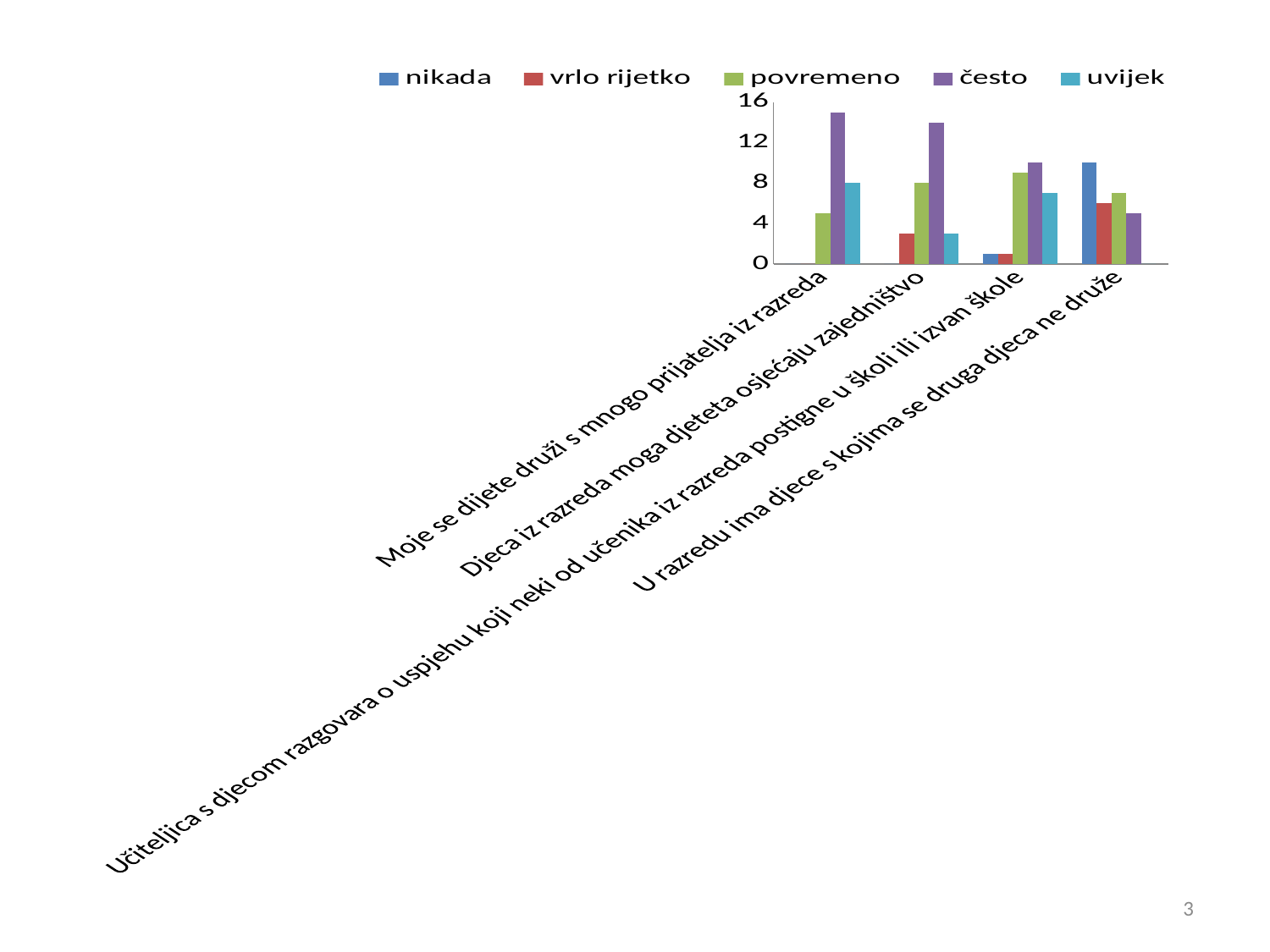
Is the value of "često" for "Moje se dijete druži s mnogo prijatelja iz razreda" greater or less than 12? greater For "U razredu ima djece s kojima se druga djeca ne druže", which is larger: "nikada" or "često"? nikada Which series has the highest value for "U razredu ima djece s kojima se druga djeca ne druže"? nikada How many series does the legend list? 5 Is the value of "uvijek" for "Djeca iz razreda moga djeteta osjećaju zajedništvo" greater or less than 4? less Which series has the highest value for "Moje se dijete druži s mnogo prijatelja iz razreda"? često What kind of chart is shown on the slide? bar chart Which category has the lowest value for "često"? U razredu ima djece s kojima se druga djeca ne druže For "Djeca iz razreda moga djeteta osjećaju zajedništvo", which is larger: "povremeno" or "često"? često Is the value of "nikada" for "U razredu ima djece s kojima se druga djeca ne druže" greater or less than 8? greater How many categories are shown on the x axis? 4 What is the first entry in the legend? nikada